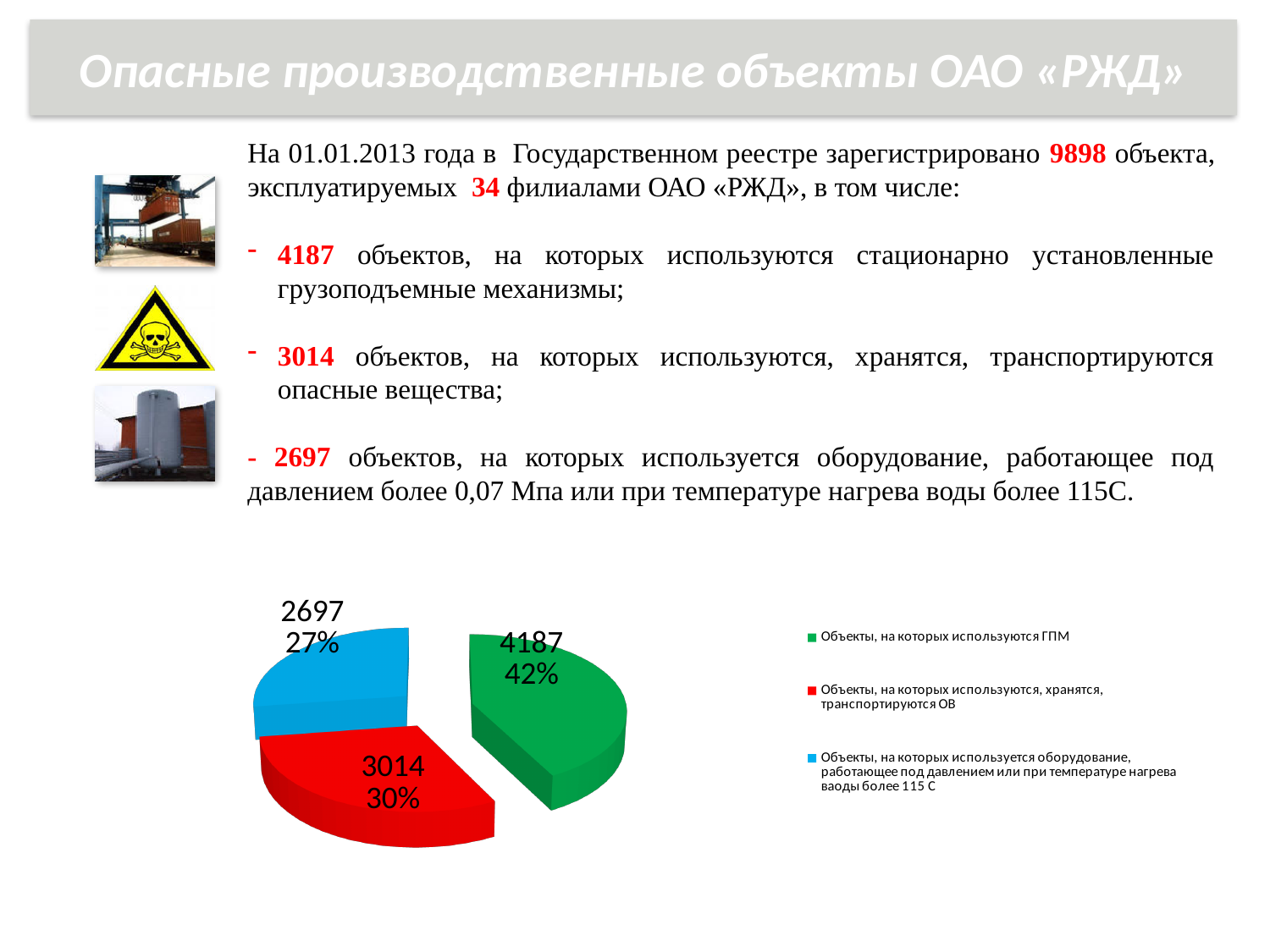
What share of the pie does the slice 'Объекты, на которых используются ГПМ' represent? 42% What share of the pie does the slice 'Объекты, на которых используются, хранятся, транспортируются ОВ' represent? 30% What value is shown for the slice 'Объекты, на которых используются, хранятся, транспортируются ОВ'? 3014 How many slices does the pie chart have? 3 What value is shown for the slice 'Объекты, на которых используется оборудование, работающее под давлением или при температуре нагрева воды более 115 С'? 2697 What value is shown for the slice 'Объекты, на которых используются ГПМ'? 4187 What kind of chart is shown on the slide? pie chart Which slice of the pie chart is the smallest? Объекты, на которых используется оборудование, работающее под давлением или при температуре нагрева воды более 115 С How many entries does the legend of the pie chart list? 3 What is the difference between the value for 'Объекты, на которых используются ГПМ' and the value for 'Объекты, на которых используются, хранятся, транспортируются ОВ'? 1173 Which slice of the pie chart is the largest? Объекты, на которых используются ГПМ What colour is the slice for 'Объекты, на которых используются, хранятся, транспортируются ОВ'? red